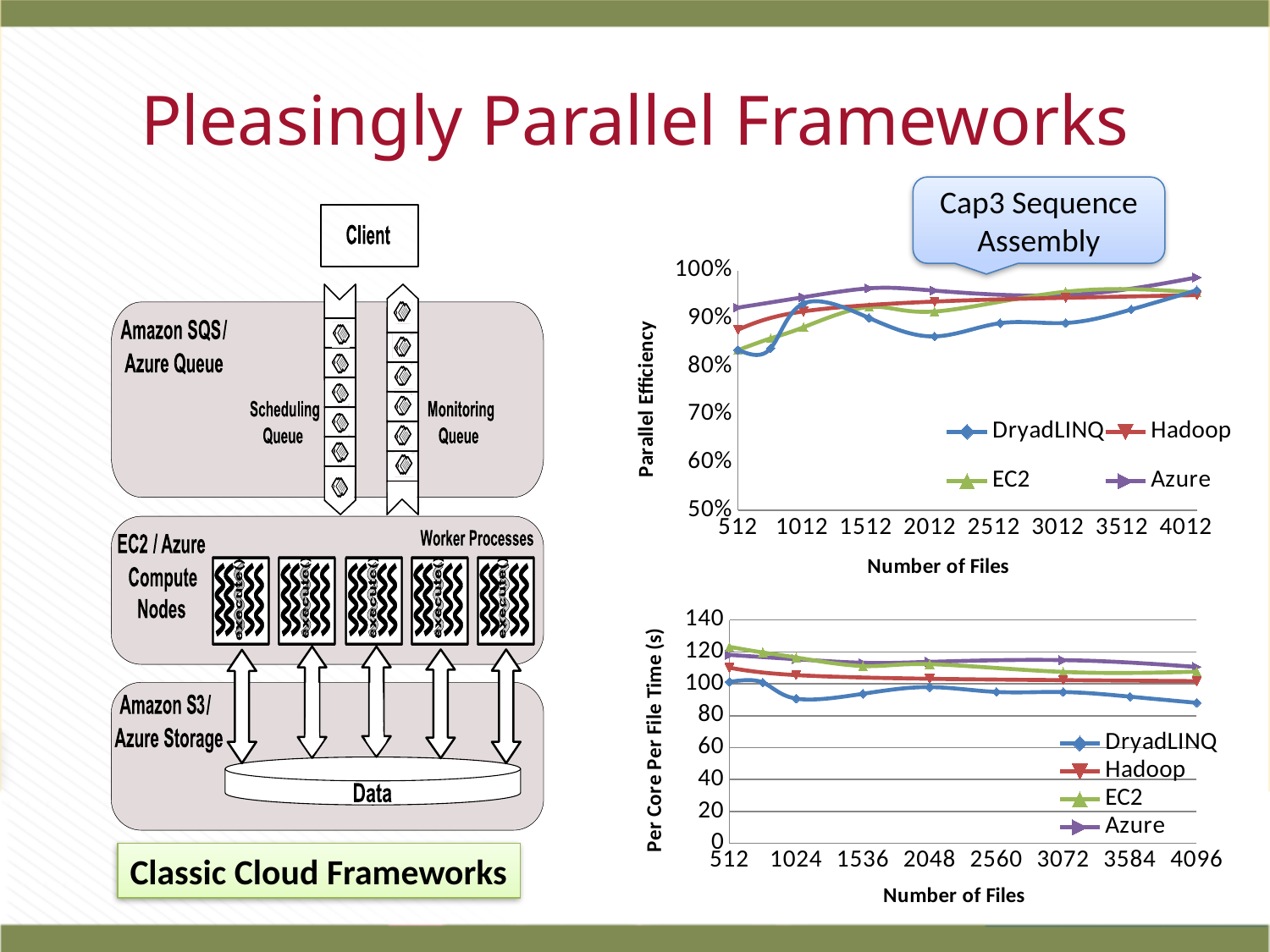
In the top chart (Parallel Efficiency), which series has the highest value at 4012 files? Azure In the bottom chart (Per Core Per File Time), how many series does the legend list? 4 What kind of chart is the top chart on the right (Parallel Efficiency vs Number of Files)? line chart In the bottom chart (Per Core Per File Time), is the value for Azure at 4096 files greater or less than 100? greater In the bottom chart (Per Core Per File Time), is the value for DryadLINQ at 4096 files greater or less than 100? less In the top chart (Parallel Efficiency), which series has the lowest value at 2012 files? DryadLINQ In the top chart (Parallel Efficiency), is the value for Azure at 512 files greater or less than 90%? greater In the top chart (Parallel Efficiency), how many series does the legend list? 4 In the bottom chart (Per Core Per File Time), which series has the lowest values across the x axis? DryadLINQ What is the x-axis title of the top chart on the right? Number of Files What kind of chart is the bottom chart on the right (Per Core Per File Time vs Number of Files)? line chart